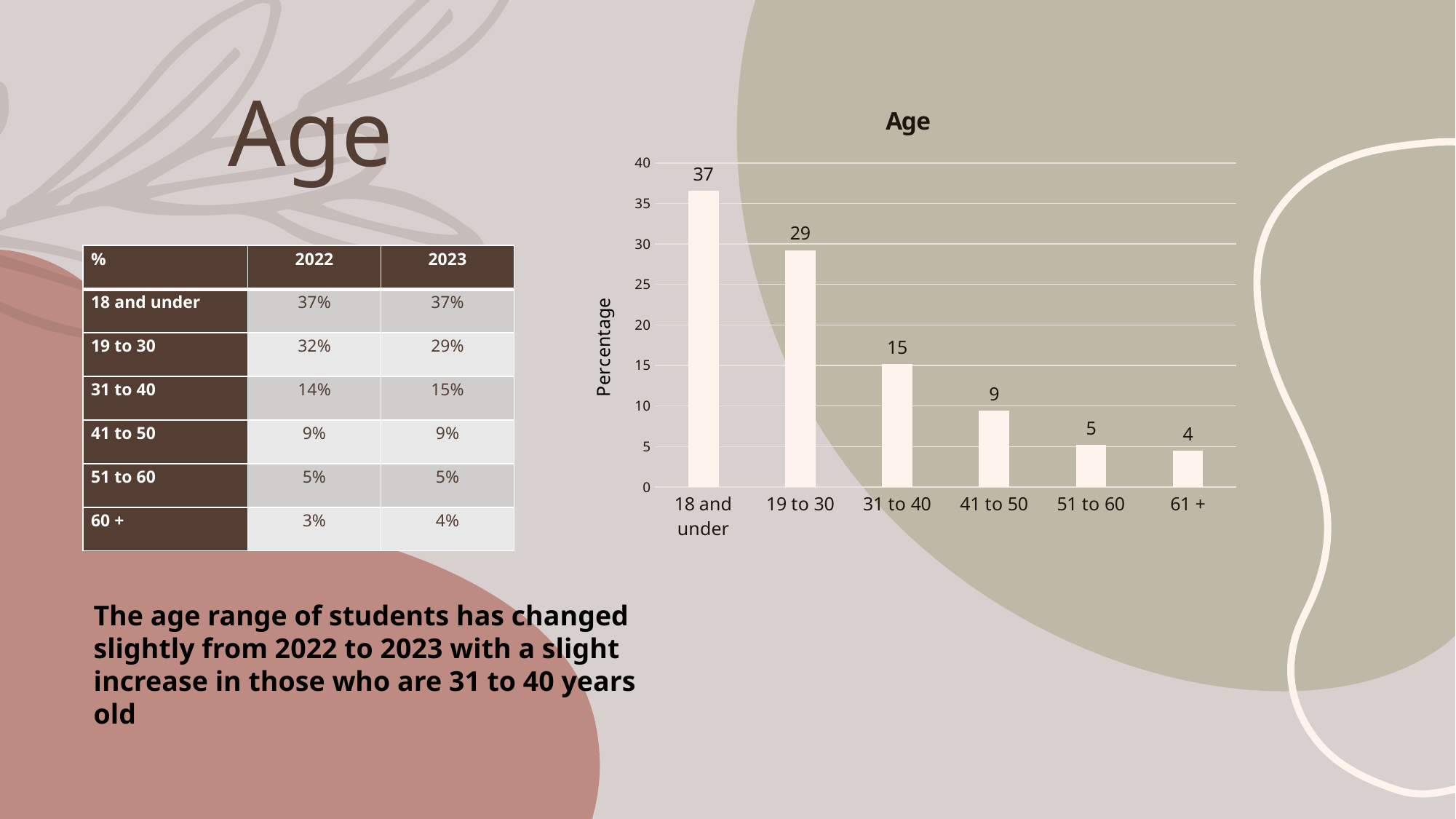
What kind of chart is shown on the slide? Bar chart Do the values in the chart rise or fall from left to right along the x axis? Fall What is the value for the 19 to 30 category in the Age chart? 29 What is the value for the 61 + category in the Age chart? 4 What is the value for the 41 to 50 category in the Age chart? 9 What is the difference between the values for 18 and under and 19 to 30 in the chart? 8 Which has a larger value in the chart, 31 to 40 or 41 to 50? 31 to 40 How many age categories are shown on the x axis of the chart? 6 Which age category has the lowest value in the chart? 61 + What is the value for the 18 and under category in the Age chart? 37 Which age category has the highest value in the chart? 18 and under What is the label on the vertical axis of the chart? Percentage